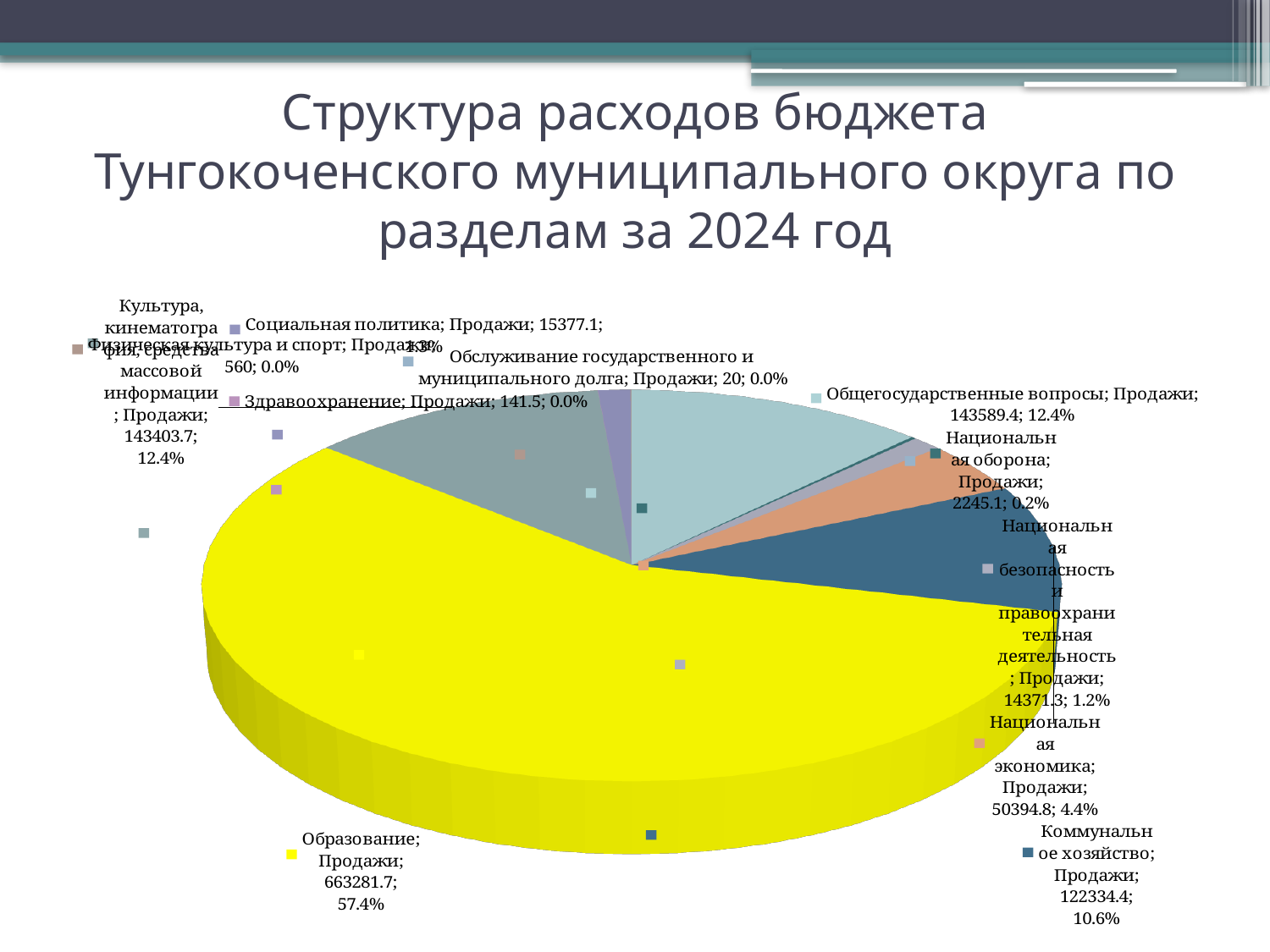
What share of the pie does Образование represent? 57.4% What is the difference between the values for Общегосударственные вопросы and Культура, кинематография, средства массовой информации? 185.7 What is the value for Образование? 663281.7 How many categories are shown in the pie chart? 11 Which category has the largest share of the pie? Образование What is the value for Национальная оборона? 2245.1 Which category has the smallest value? Обслуживание государственного и муниципального долга What kind of chart is shown on the slide? pie chart Which is larger, the value for Коммунальное хозяйство or the value for Национальная экономика? Коммунальное хозяйство What is the value for Национальная экономика? 50394.8 What is the value for Коммунальное хозяйство? 122334.4 What share of the pie does Общегосударственные вопросы represent? 12.4%